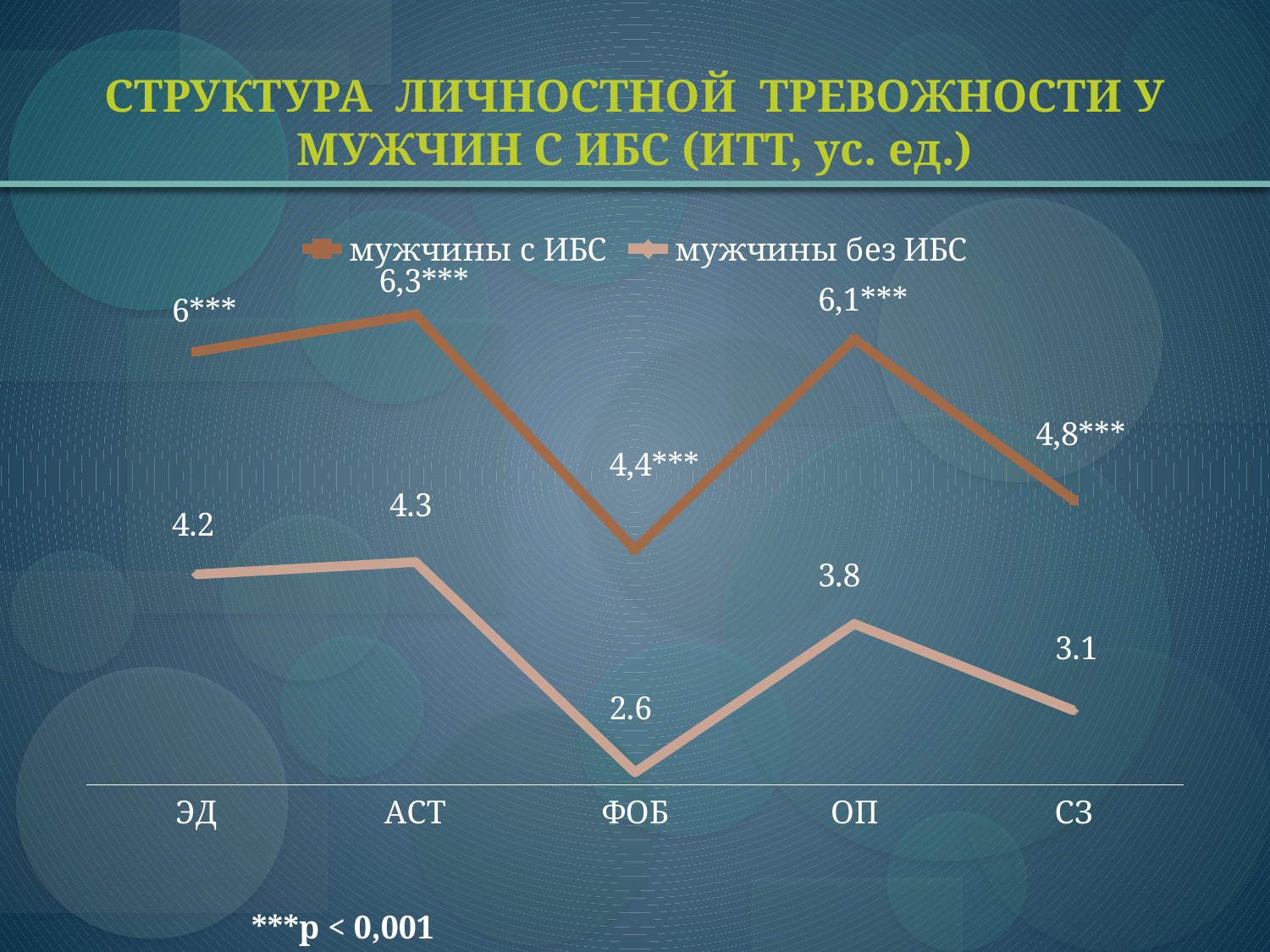
How many categories are shown on the x axis? 5 Which is larger for ОП: the value for "мужчины с ИБС" or for "мужчины без ИБС"? мужчины с ИБС Does the series "мужчины без ИБС" rise or fall from ОП to СЗ? fall How many series does the legend list? 2 What is the difference between the АСТ and ФОБ values in the series "мужчины без ИБС"? 1.7 What is the value for ФОБ in the series "мужчины без ИБС"? 2.6 What is the value for СЗ in the series "мужчины с ИБС"? 4,8*** What type of chart is shown on the slide? line chart Which category has the lowest value in the series "мужчины без ИБС"? ФОБ Which category has the highest value in the series "мужчины с ИБС"? АСТ What does the note "***" at the bottom of the slide indicate? p < 0,001 What is the value for АСТ in the series "мужчины с ИБС"? 6,3***